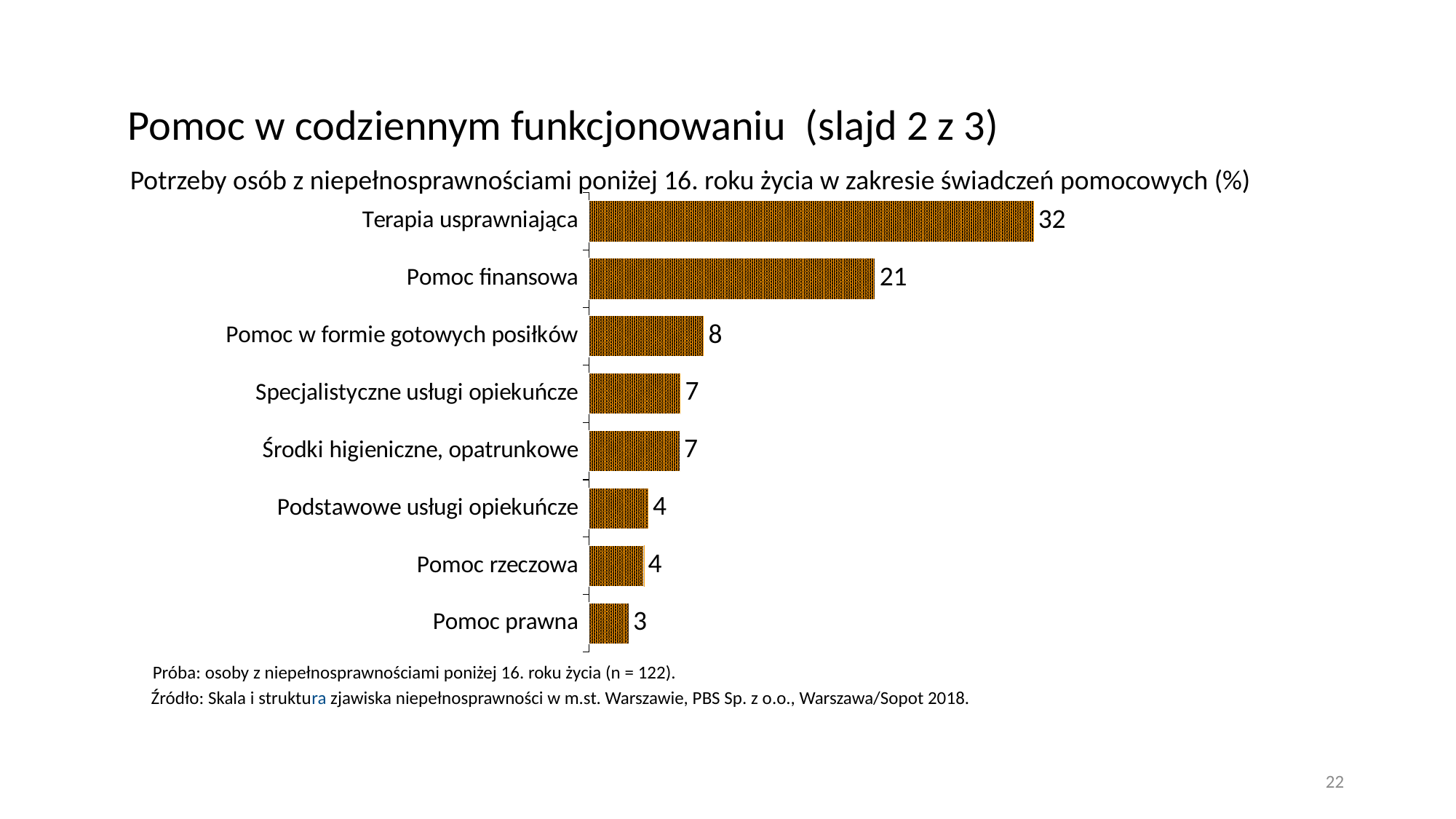
What is the value for Pomoc prawna? 3 Which is larger, the value for Pomoc w formie gotowych posiłków or the value for Specjalistyczne usługi opiekuńcze? Pomoc w formie gotowych posiłków Which category has the highest value? Terapia usprawniająca What is the value for Środki higieniczne, opatrunkowe? 7 Which category has the lowest value? Pomoc prawna What is the sample size (n) stated below the chart? 122 What kind of chart is shown on the slide? bar chart What is the value for Pomoc finansowa? 21 How many categories are shown in the chart? 8 What is the value for Pomoc w formie gotowych posiłków? 8 What is the value for Terapia usprawniająca? 32 What is the difference between the values for Terapia usprawniająca and Pomoc finansowa? 11